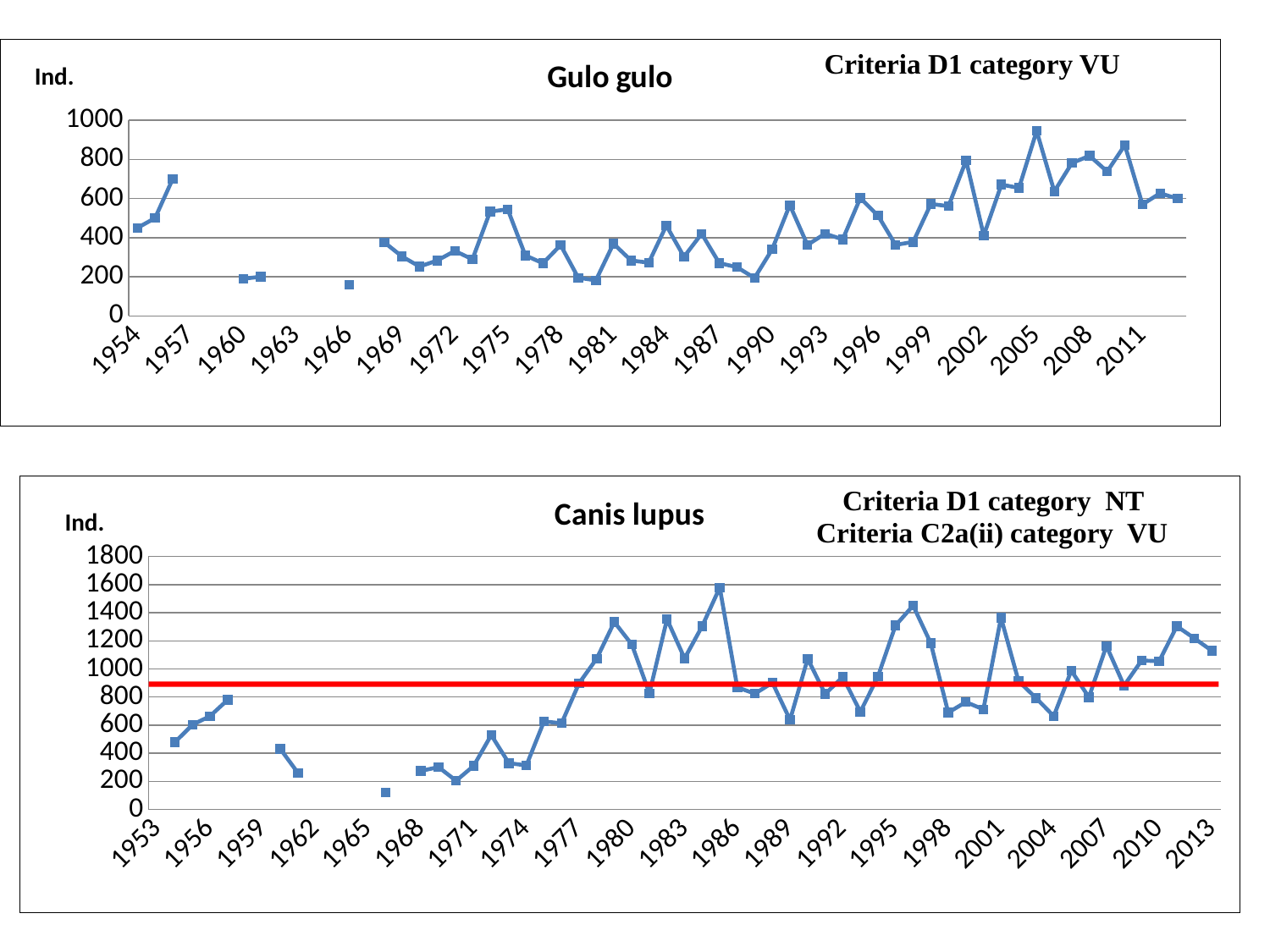
What kind of chart is the Gulo gulo chart at the top of the slide? line chart In the Gulo gulo chart, is the value for 2005 greater or less than 800? greater In the Gulo gulo chart, is the value for 1966 greater or less than 200? less In the Canis lupus chart, is the value for 2013 greater or less than 1000? greater In the Gulo gulo chart, do the values generally rise or fall between 1990 and 2005? rise What kind of chart is the Canis lupus chart at the bottom of the slide? line chart What is the highest value shown on the y axis of the Canis lupus chart? 1800 What colour is the horizontal reference line drawn across the Canis lupus chart? red